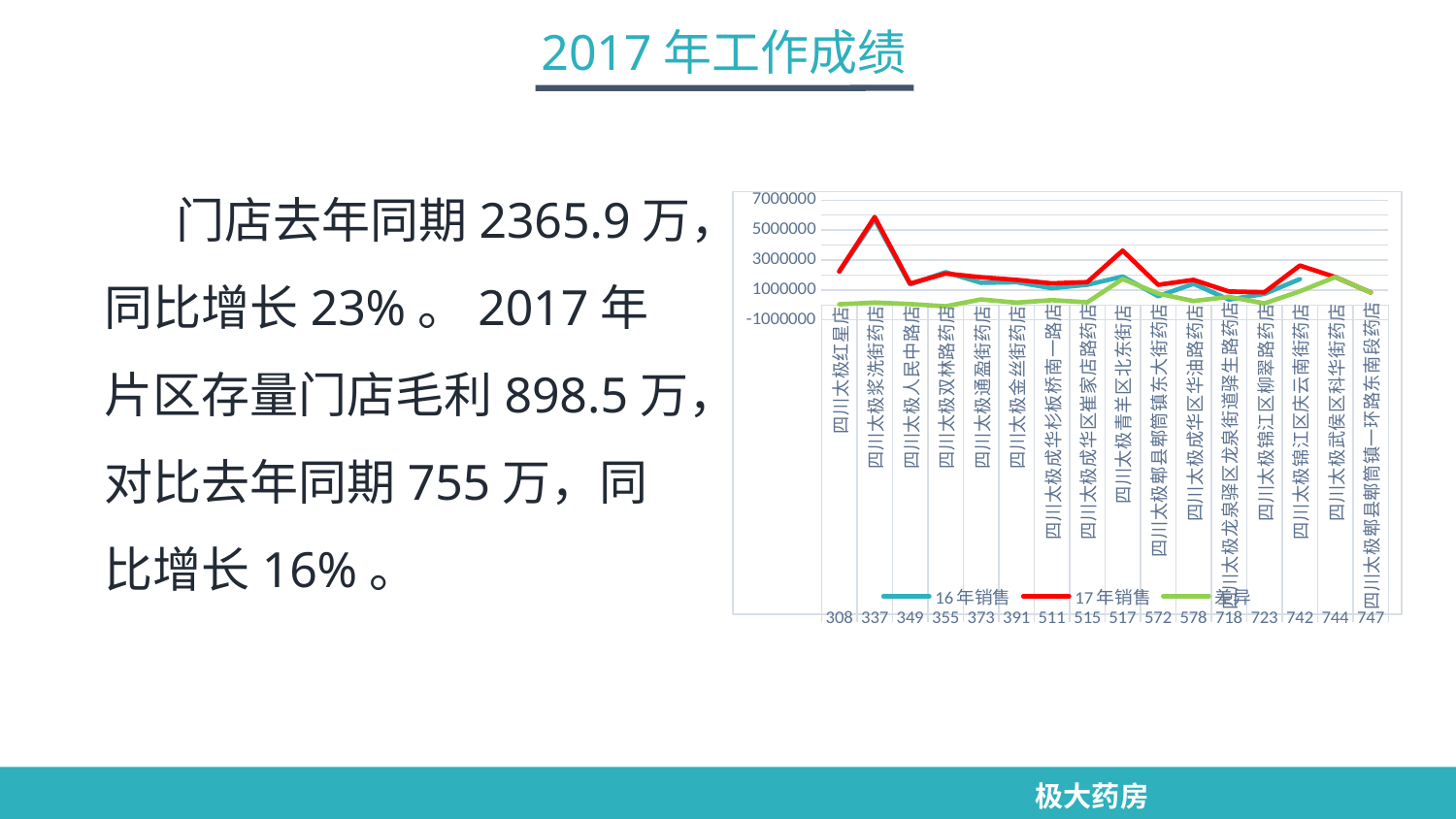
Is the 17年销售 value for 四川太极青羊区北东街店 greater or less than 3000000? greater What is the highest value shown on the chart's vertical axis? 7000000 Is the 16年销售 value for 四川太极红星店 greater or less than 1000000? greater What kind of chart is shown on the slide? line chart Does the 17年销售 line rise or fall from 四川太极浆洗街药店 to 四川太极人民中路店? fall Which store has the highest 17年销售 value in the chart? 四川太极浆洗街药店 Does the 17年销售 line rise or fall from 四川太极红星店 to 四川太极浆洗街药店? rise How many series does the chart's legend list? 3 What colour is the 17年销售 line in the chart? red How many store categories are plotted along the x axis of the chart? 16 Is the 17年销售 value for 四川太极浆洗街药店 greater or less than 5000000? greater